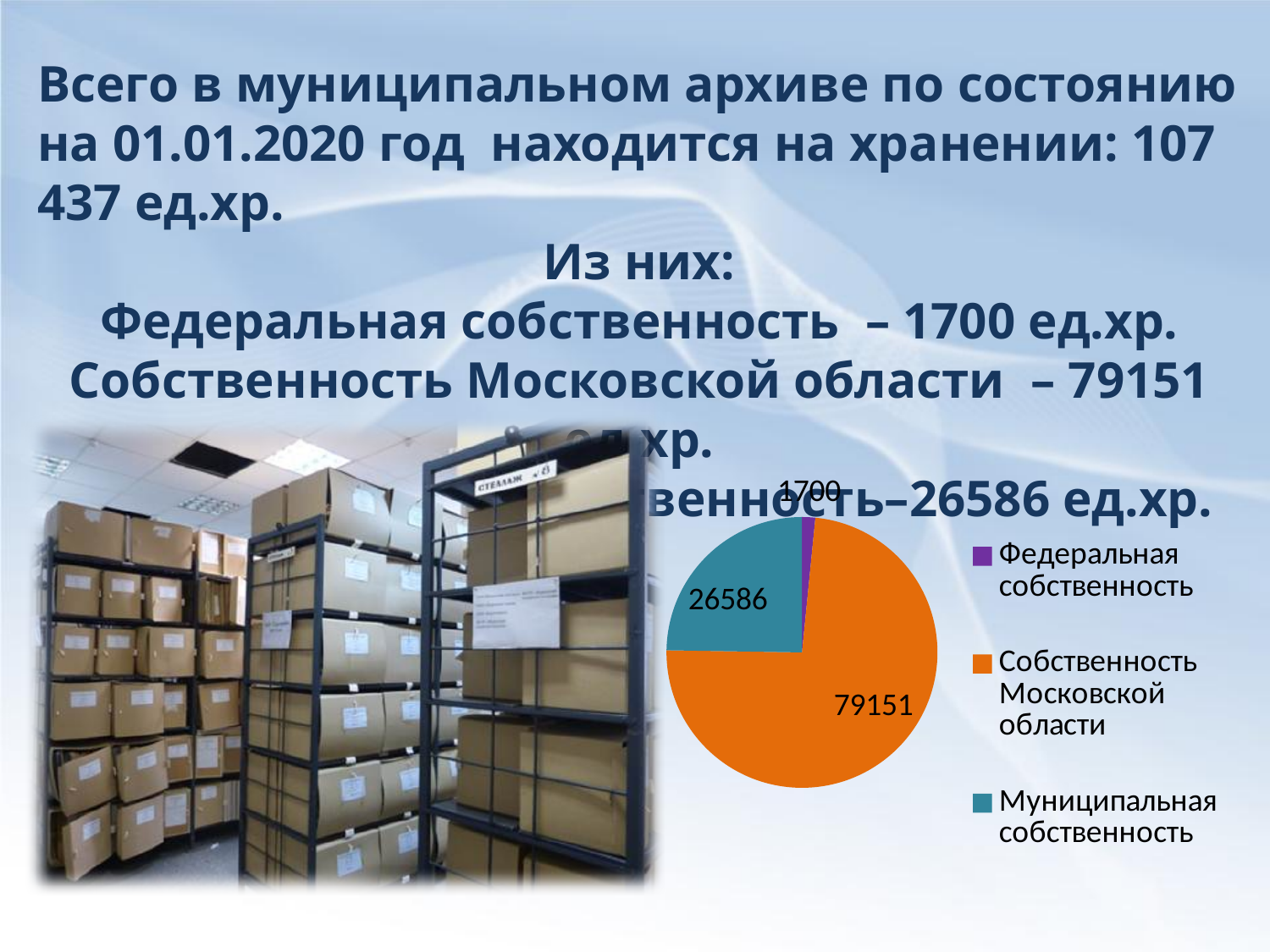
Which category has the largest slice in the pie chart? Собственность Московской области Which is larger: Муниципальная собственность or Федеральная собственность? Муниципальная собственность What is the difference between the values for Собственность Московской области and Муниципальная собственность? 52565 What is the value for Федеральная собственность in the pie chart? 1700 What is the value for Муниципальная собственность in the pie chart? 26586 What is the difference between the values for Муниципальная собственность and Федеральная собственность? 24886 What is the value for Собственность Московской области in the pie chart? 79151 Which category has the smallest slice in the pie chart? Федеральная собственность What is the total of all slices in the pie chart? 107437 How many slices does the pie chart have? 3 What colour is the slice for Собственность Московской области? orange What type of chart is shown on the slide? pie chart